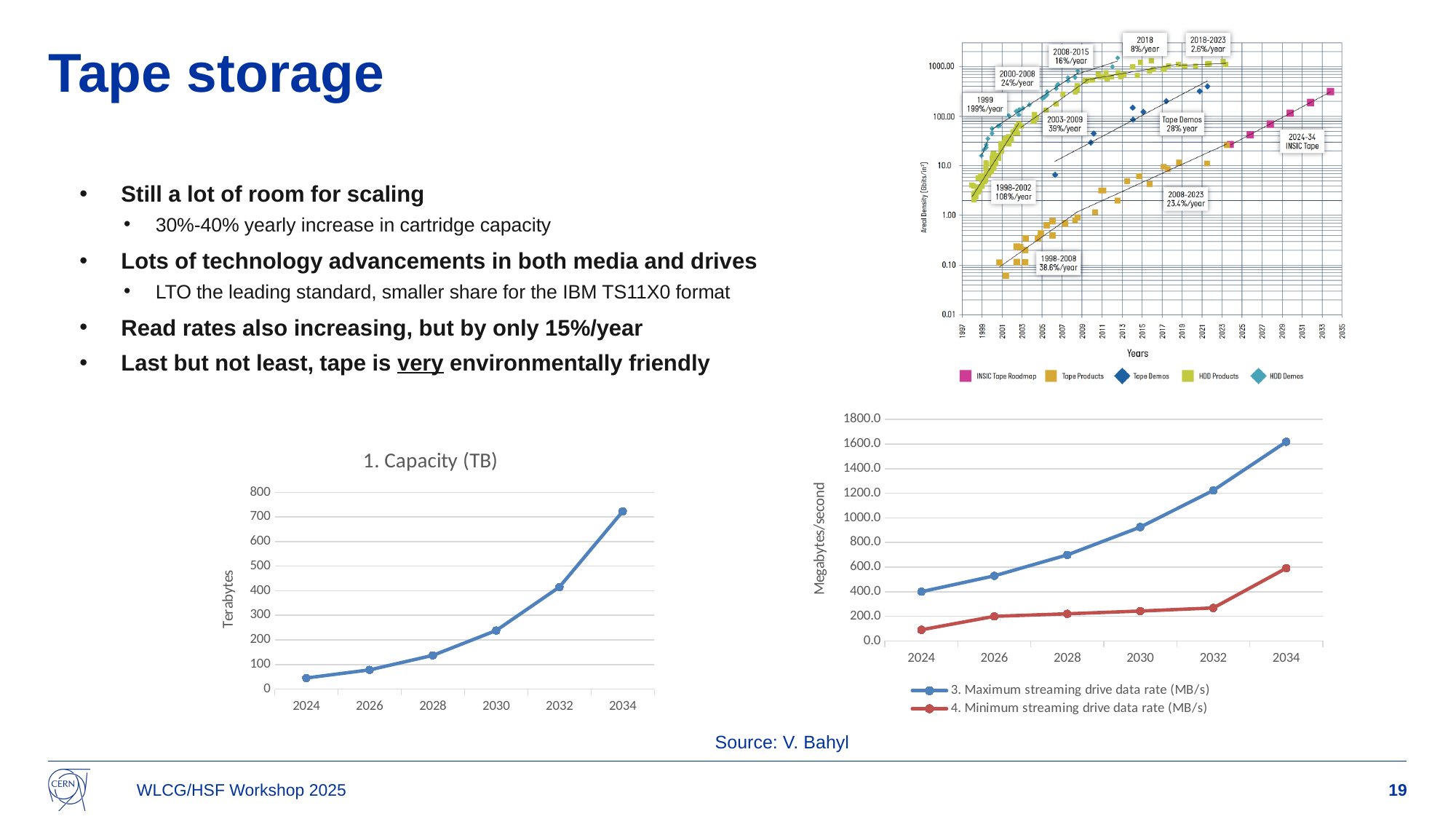
In the bottom-right streaming drive data rate chart, is the maximum streaming drive data rate for 2034 greater or less than 1400.0? greater What kind of chart is the "1. Capacity (TB)" chart at the bottom left? line chart In the "1. Capacity (TB)" chart, is the value for 2034 greater or less than 600? greater In the "1. Capacity (TB)" chart, what is the label on the vertical axis? Terabytes In the bottom-right streaming drive data rate chart, how many series does the legend list? 2 In the bottom-right streaming drive data rate chart, which is larger in 2030: the maximum streaming drive data rate or the minimum streaming drive data rate? Maximum streaming drive data rate In the "1. Capacity (TB)" chart, is the value for 2024 greater or less than 100? less In the "1. Capacity (TB)" chart, how many years are shown on the x axis? 6 In the top-right areal density chart, how many entries does the legend list? 5 In the "1. Capacity (TB)" chart, do the values rise or fall from 2024 to 2034? rise In the "1. Capacity (TB)" chart, which year has the highest capacity? 2034